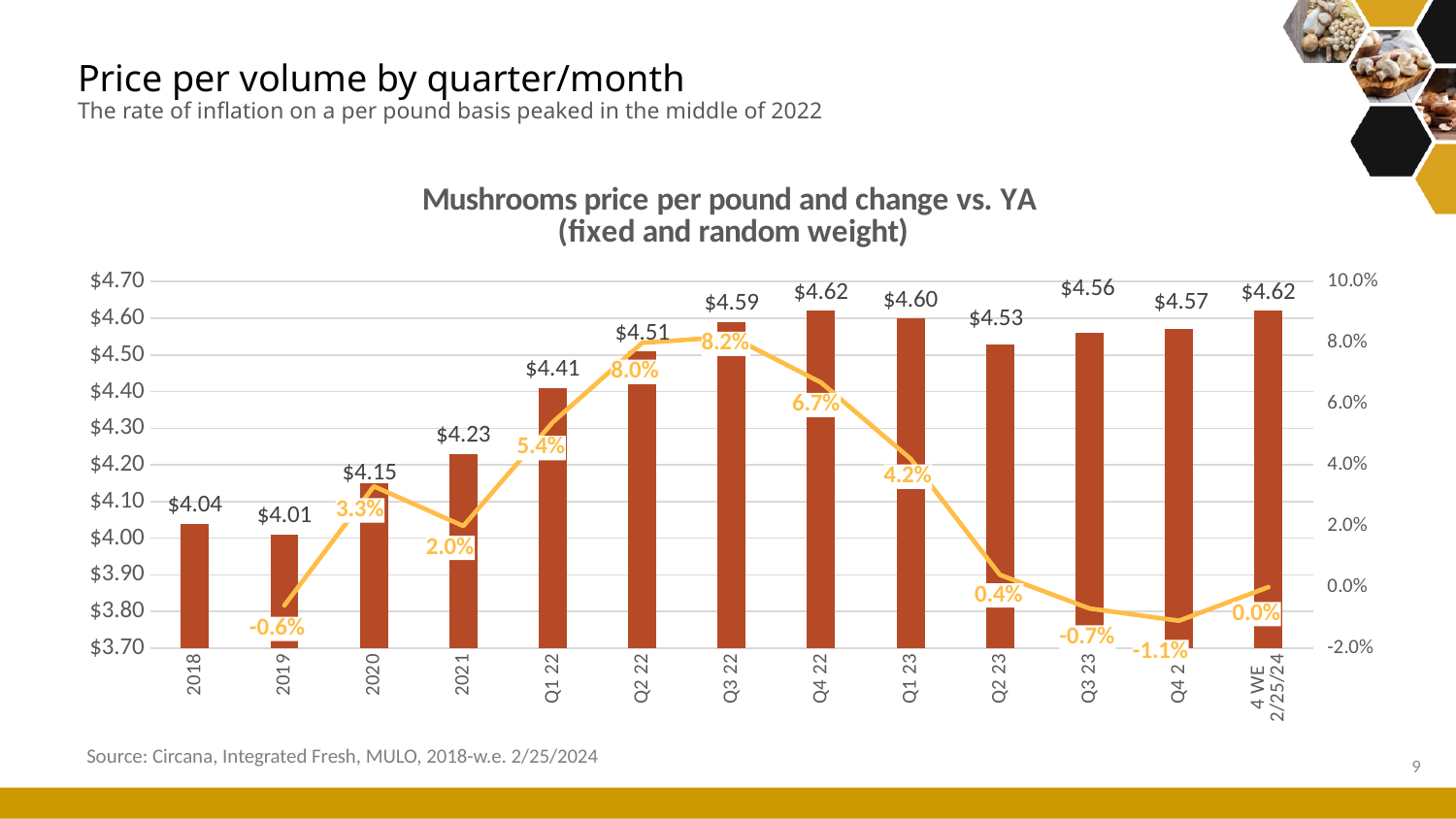
Is the price per pound for 2021 greater or less than $4.30? less What is the change vs. YA shown for Q3 22? 8.2% What kind of chart is this? Combined bar and line chart Which period has the lowest price per pound? 2019 What is the mushroom price per pound for Q1 22? $4.41 Does the change vs. YA line rise or fall from Q3 22 to Q4 2 (Q4 23)? fall What is the price per pound shown for 2018? $4.04 Which period has the highest change vs. YA? Q3 22 Which is higher, the price per pound for Q2 23 or for Q3 23? Q3 23 What is the difference in price per pound between Q4 22 and 2018? $0.58 What is the change vs. YA shown for Q4 2 (Q4 23)? -1.1% How many periods are shown on the x axis? 13